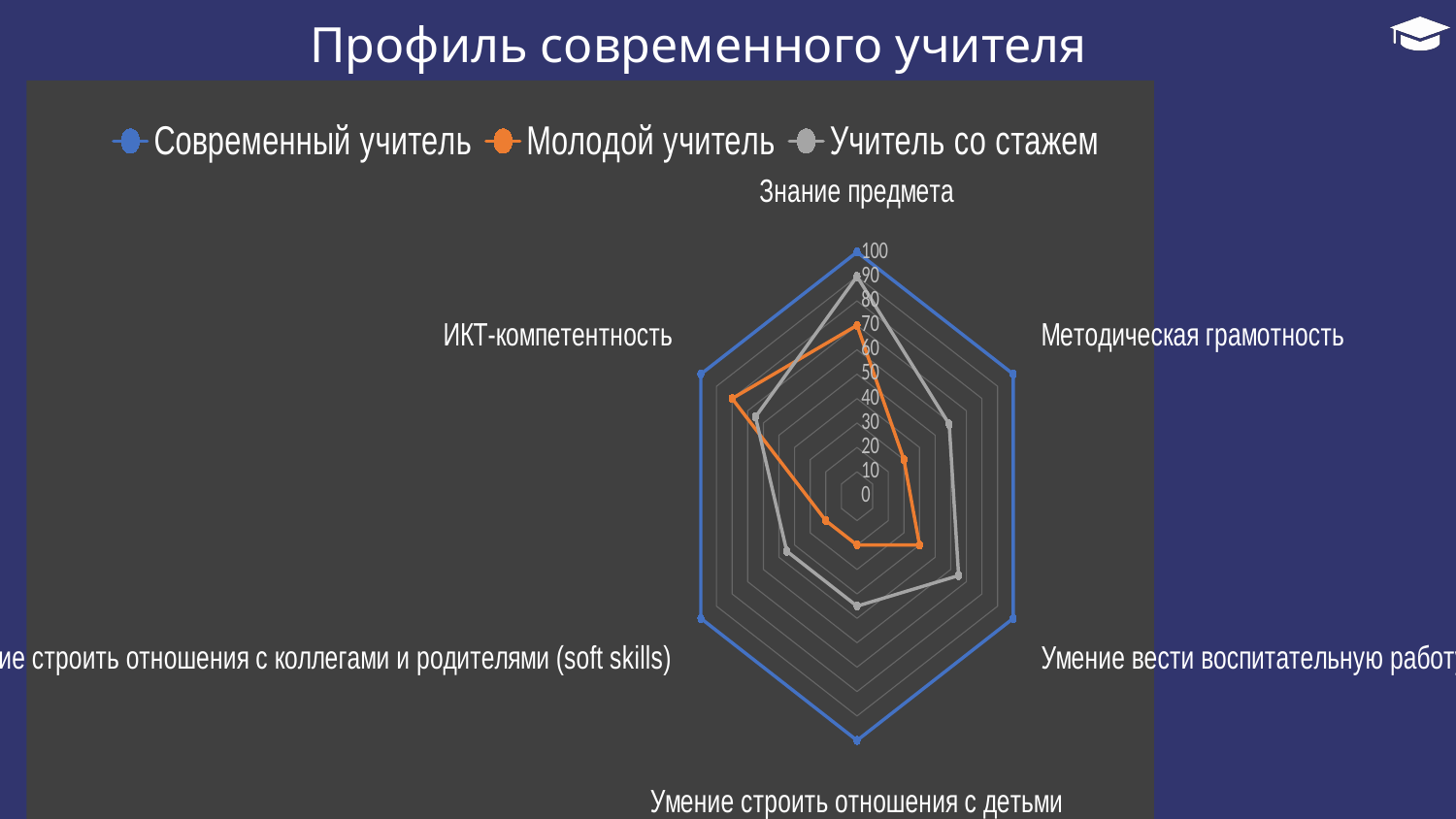
What kind of chart is shown on the slide? Radar chart Which series is drawn in orange? Молодой учитель How many series does the legend list? 3 What is the value of Учитель со стажем for Знание предмета? 90 What is the value of Молодой учитель for Знание предмета? 70 Is the value of Молодой учитель for Умение строить отношения с детьми greater or less than 50? less What is the value of Современный учитель for Знание предмета? 100 Which series has the higher value for ИКТ-компетентность, Молодой учитель or Учитель со стажем? Молодой учитель What is the difference between Современный учитель and Молодой учитель for Знание предмета? 30 Is the value of Молодой учитель for ИКТ-компетентность greater or less than 50? greater How many categories (axes) does the radar chart have? 6